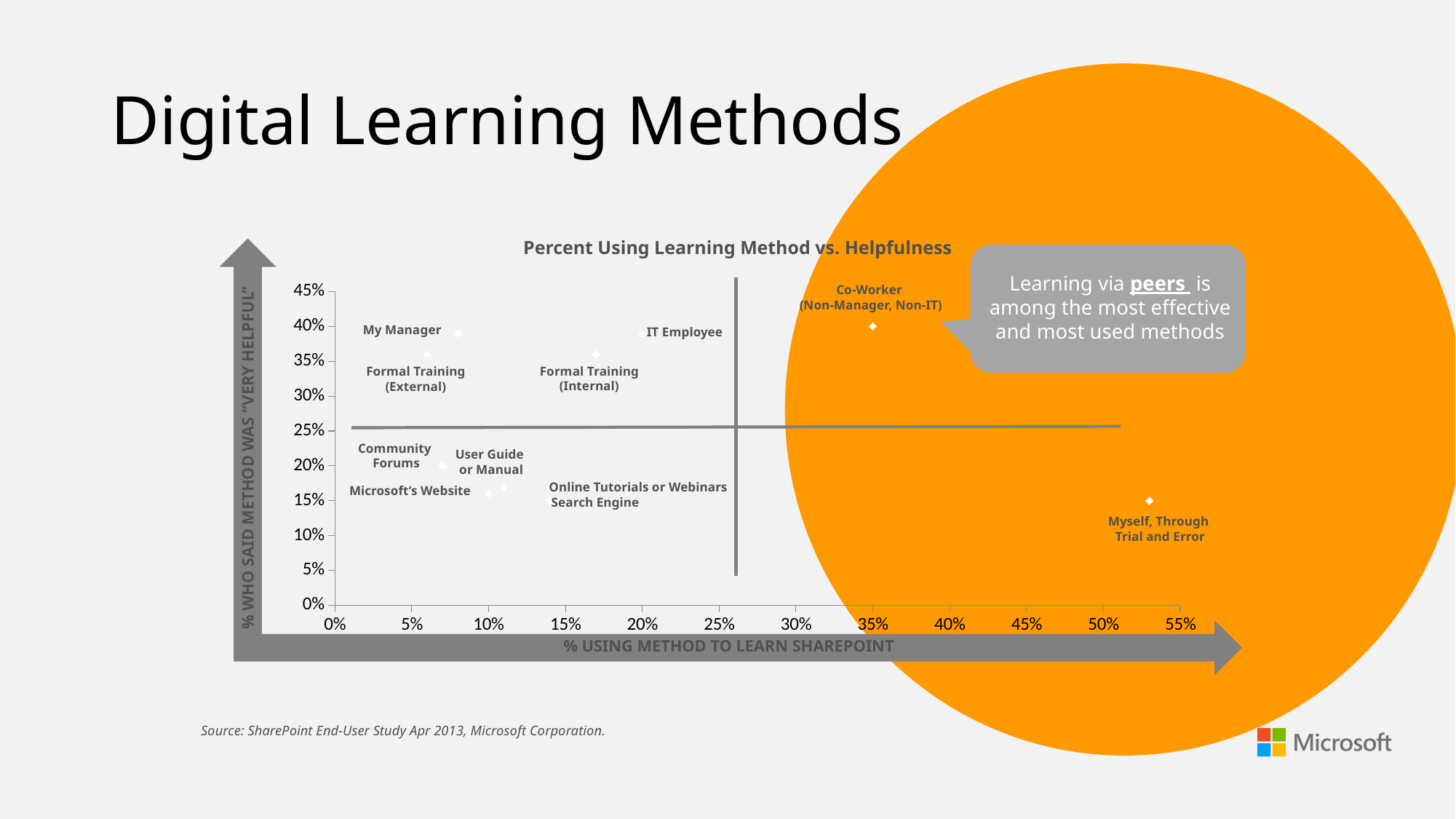
Is the percentage who said 'Community Forums' was very helpful greater or less than 25%? less What is the label of the horizontal axis of the chart? % USING METHOD TO LEARN SHAREPOINT Is the percentage who said 'Myself, Through Trial and Error' was very helpful greater or less than 25%? less Which method was rated very helpful by a higher percentage: 'My Manager' or 'Microsoft's Website'? My Manager Which method has a higher percentage of users: 'Myself, Through Trial and Error' or 'Co-Worker (Non-Manager, Non-IT)'? Myself, Through Trial and Error What is the title of the chart? Percent Using Learning Method vs. Helpfulness Is the percentage using the method for 'Myself, Through Trial and Error' greater or less than 50%? greater Which learning method has the highest percentage of people using it to learn SharePoint? Myself, Through Trial and Error What kind of chart is shown on the slide? Scatter chart Which method was rated very helpful by a higher percentage: 'Co-Worker (Non-Manager, Non-IT)' or 'Community Forums'? Co-Worker (Non-Manager, Non-IT)